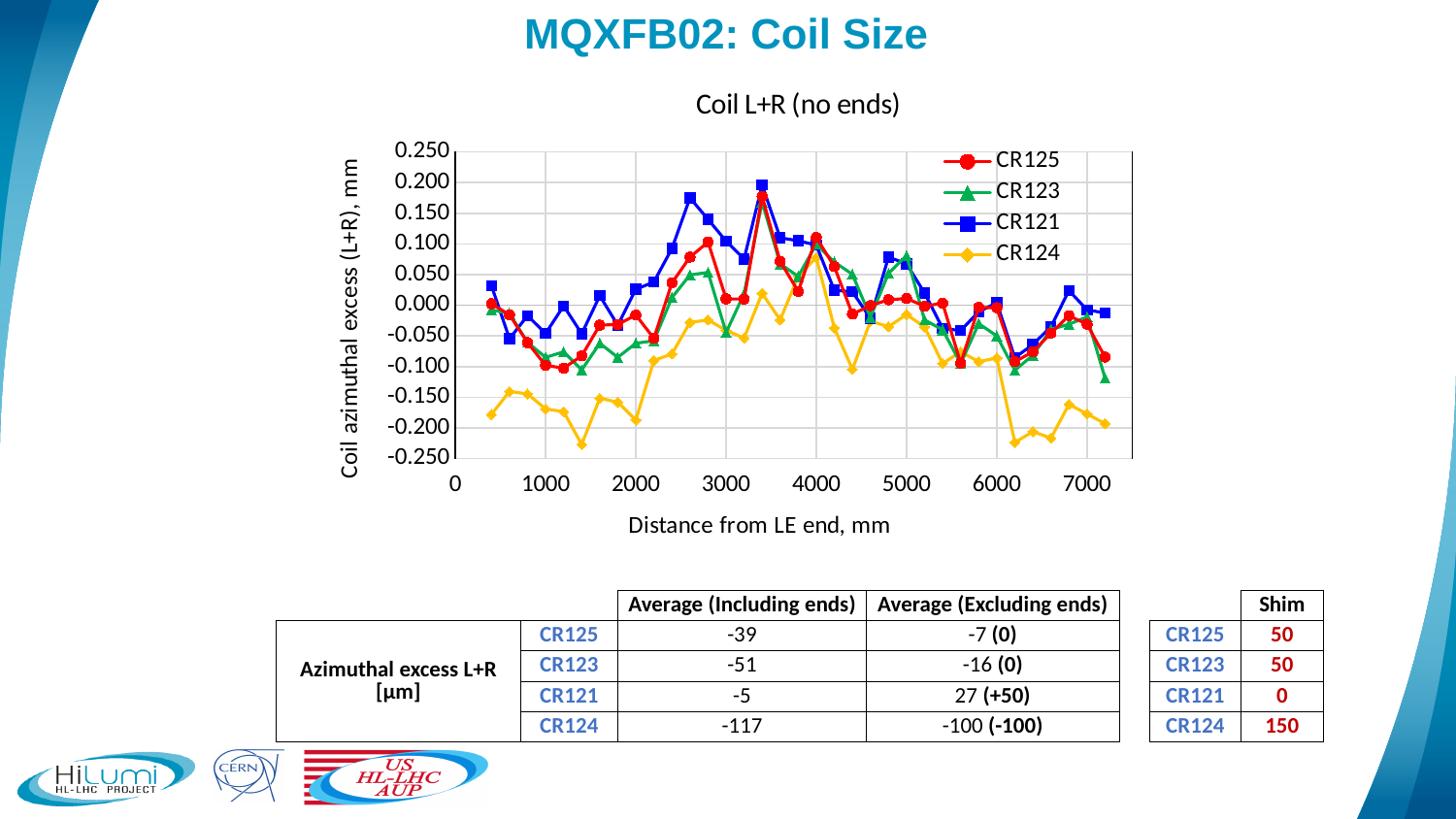
At about 3400 mm, which series has the larger value, CR121 or CR124? CR121 Is the peak value for CR121 at about 3400 mm greater or less than 0.150? greater At about 1400 mm, which series has the larger value, CR121 or CR124? CR121 What kind of chart is shown on the slide? line chart Is the value for CR124 at about 6200 mm greater or less than -0.200? less Is the value for CR121 at about 2600 mm greater or less than 0.150? greater Which series has the lowest values on the chart? CR124 What is the label of the x axis of the chart? Distance from LE end, mm Which series reaches the highest value on the chart? CR121 How many series does the chart legend list? 4 What is the title of the chart? Coil L+R (no ends)